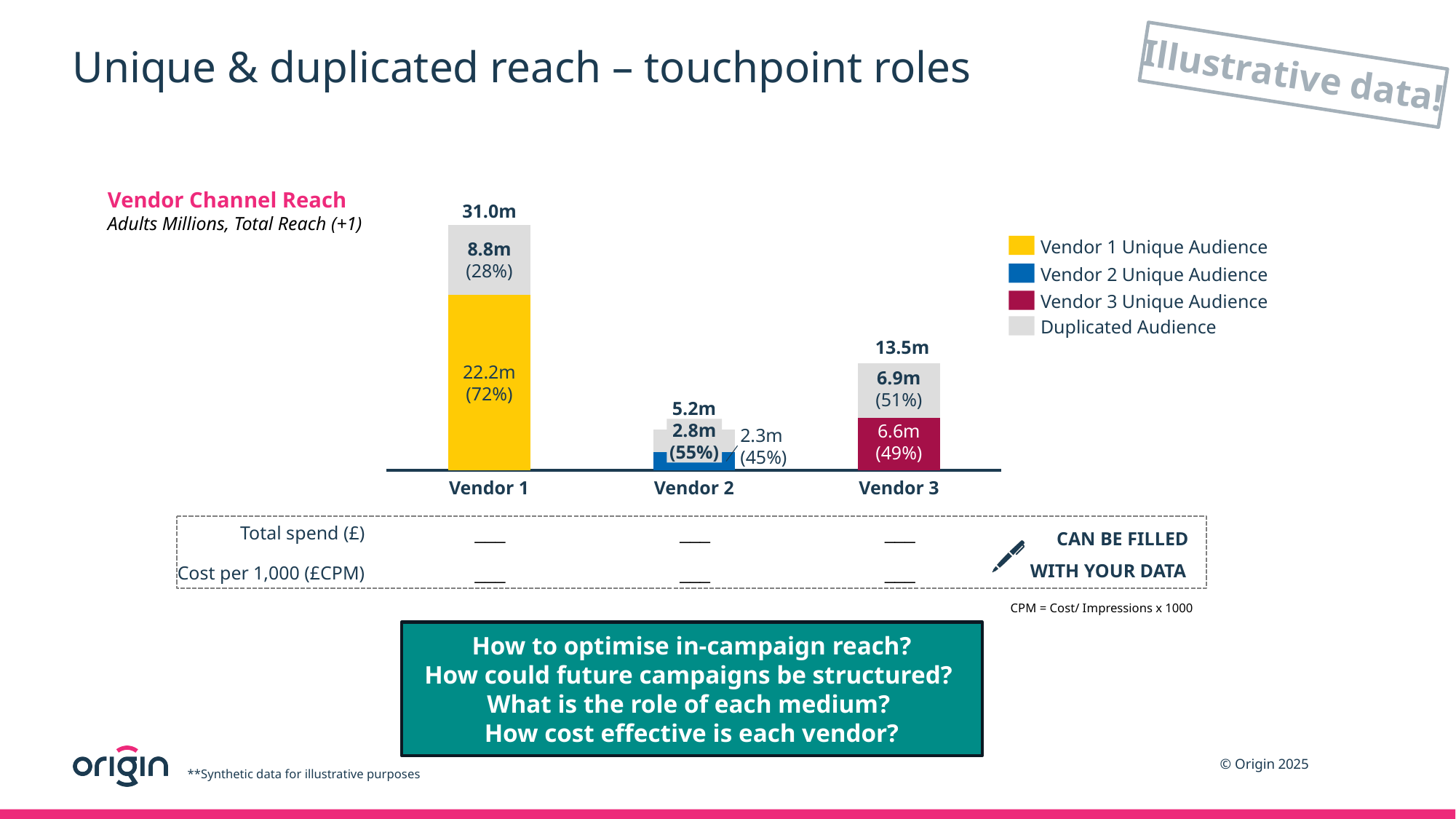
Which is larger, the Duplicated Audience for Vendor 1 or for Vendor 3? Vendor 1 What is the difference between the total reach of Vendor 1 and Vendor 3? 17.5m What percentage of Vendor 1's reach is Duplicated Audience? 28% How many vendors are shown on the x axis of the chart? 3 Which vendor has the highest total reach? Vendor 1 What is the Vendor 2 Unique Audience value? 2.3m What is the Duplicated Audience value for Vendor 3? 6.9m What colour represents Vendor 3 Unique Audience in the chart? Dark red How many entries does the chart legend list? 4 What kind of chart is used to show Vendor Channel Reach? Stacked bar chart Which vendor has the lowest total reach? Vendor 2 What is the total reach shown for Vendor 1? 31.0m